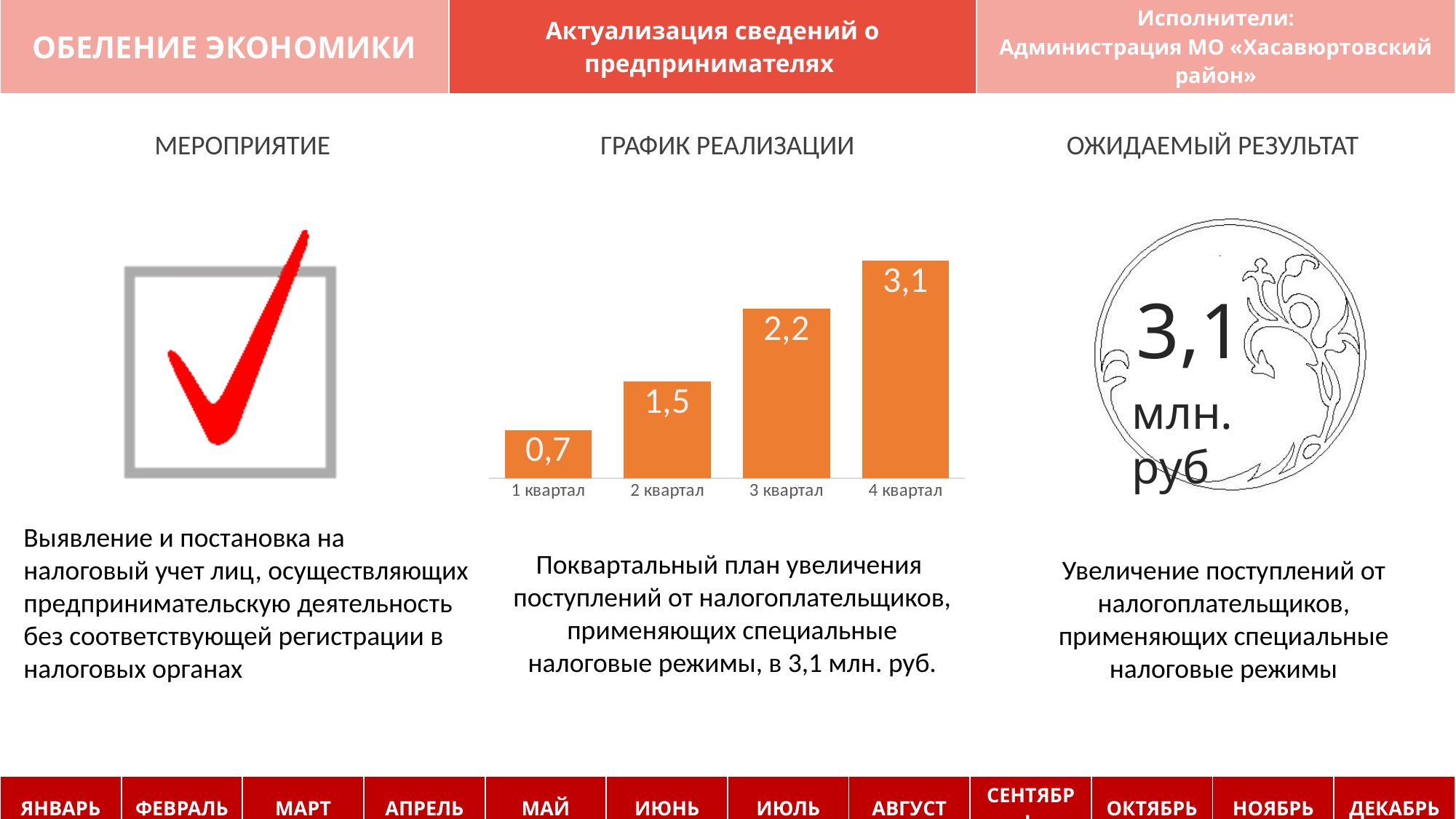
What is the difference between the values for 3 квартал and 2 квартал? 0,7 What is the value for 3 квартал? 2,2 What is the value for 2 квартал? 1,5 What is the difference between the values for 4 квартал and 1 квартал? 2,4 What is the value for 1 квартал? 0,7 Which is larger, the value for 2 квартал or the value for 3 квартал? 3 квартал What kind of chart is shown under ГРАФИК РЕАЛИЗАЦИИ? bar chart Which quarter has the lowest value? 1 квартал Do the values rise or fall from 1 квартал to 4 квартал? rise Which quarter has the highest value? 4 квартал How many quarters are shown in the chart? 4 What is the value for 4 квартал? 3,1